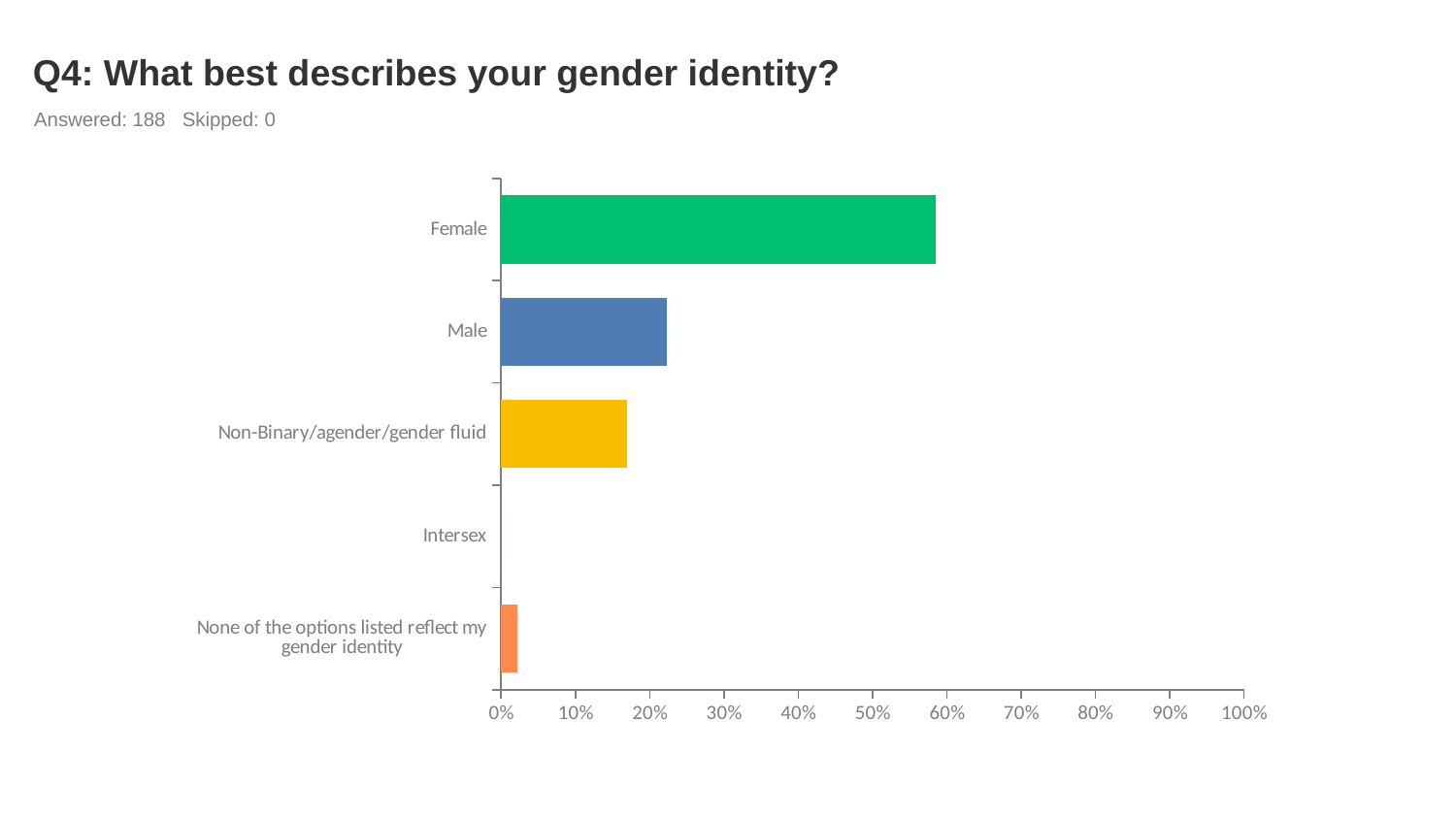
Which category has the lowest value? Intersex How many respondents answered the question according to the slide? 188 Is the value for Female greater or less than 50%? greater Which is larger, the value for Female or the value for Male? Female Which category has the highest value? Female Is the value for Male greater or less than 30%? less Is the value for 'None of the options listed reflect my gender identity' greater or less than 10%? less What kind of chart is shown on the slide? bar chart Which is larger, the value for Male or the value for Non-Binary/agender/gender fluid? Male How many categories are shown on the chart? 5 What is the title of the chart? Q4: What best describes your gender identity?